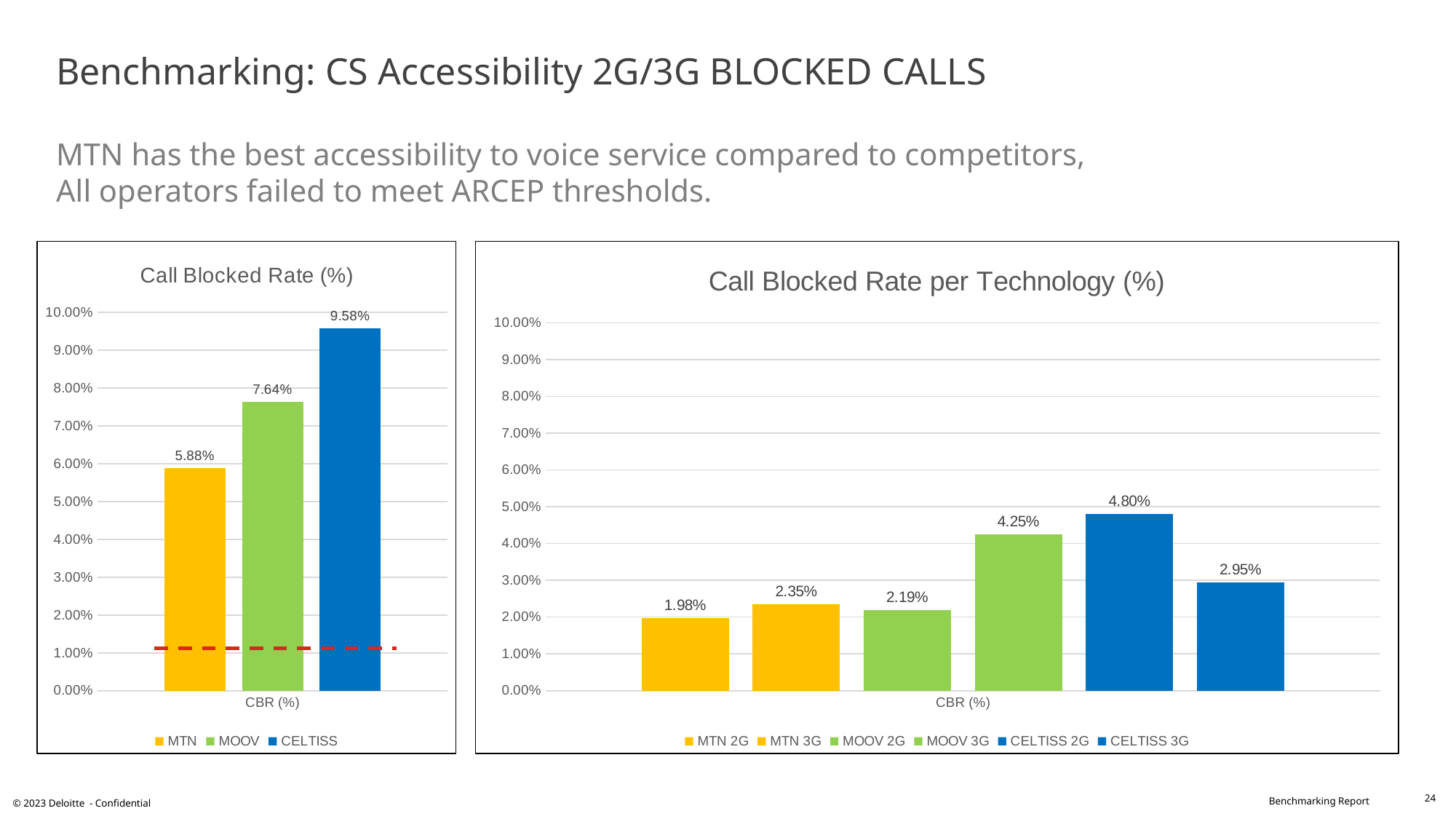
In the 'Call Blocked Rate per Technology (%)' chart, which is larger, MTN 3G or MOOV 2G? MTN 3G In the 'Call Blocked Rate per Technology (%)' chart, which series has the lowest value? MTN 2G In the 'Call Blocked Rate (%)' chart, how many series does the legend list? 3 In the 'Call Blocked Rate (%)' chart, which operator has the highest call blocked rate? CELTISS In the 'Call Blocked Rate per Technology (%)' chart, what is the value for MOOV 3G? 4.25% In the 'Call Blocked Rate (%)' chart, what is the value for MTN? 5.88% In the 'Call Blocked Rate per Technology (%)' chart, what is the value for CELTISS 2G? 4.80% In the 'Call Blocked Rate (%)' chart, which operator has the lowest call blocked rate? MTN What kind of chart is the 'Call Blocked Rate per Technology (%)' chart? Bar chart In the 'Call Blocked Rate per Technology (%)' chart, what is the difference between CELTISS 2G and CELTISS 3G? 1.85% In the 'Call Blocked Rate (%)' chart, what is the difference between the CELTISS and MOOV values? 1.94% In the 'Call Blocked Rate (%)' chart, what is the value for CELTISS? 9.58%